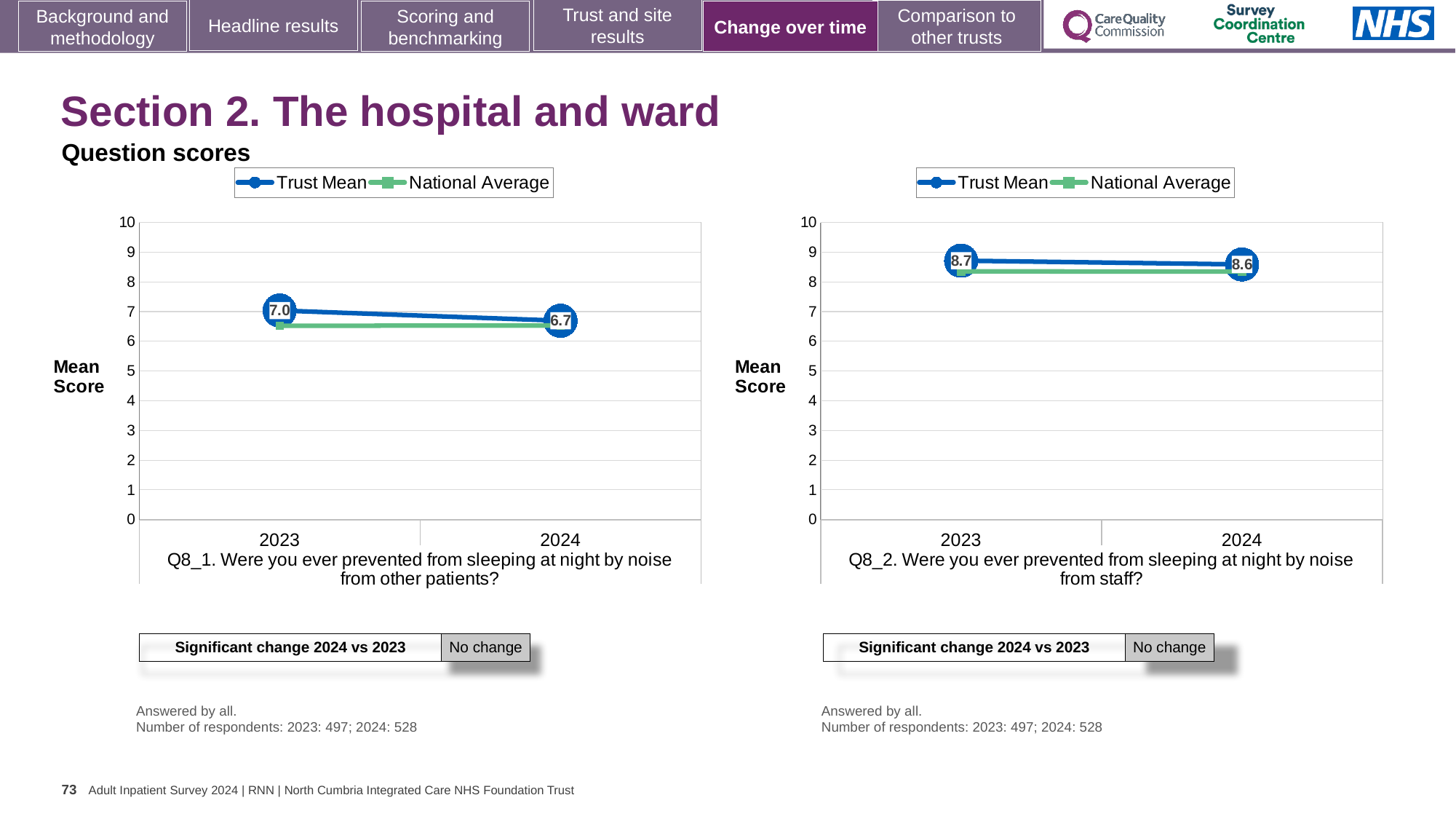
In the Q8_1 chart (left), is the National Average for 2023 greater or less than 7? less In the Q8_1 chart (left), what is the Trust Mean for 2023? 7.0 In the Q8_1 chart (left), does the Trust Mean rise or fall from 2023 to 2024? fall In the Q8_1 chart (left), by how much did the Trust Mean change from 2023 to 2024? 0.3 In the Q8_2 chart (right), what is the difference between the Trust Mean in 2023 and 2024? 0.1 What kind of chart is the Q8_2 chart (right)? line chart In the Q8_2 chart (right), what is the Trust Mean for 2023? 8.7 In the Q8_2 chart (right), what is the Trust Mean for 2024? 8.6 In the Q8_1 chart (left), what is the Trust Mean for 2024? 6.7 How many years are plotted on the x axis of the Q8_2 chart (right)? 2 How many series does the legend of the Q8_1 chart (left) list? 2 In the Q8_2 chart (right), is the National Average for 2024 greater or less than 8? greater